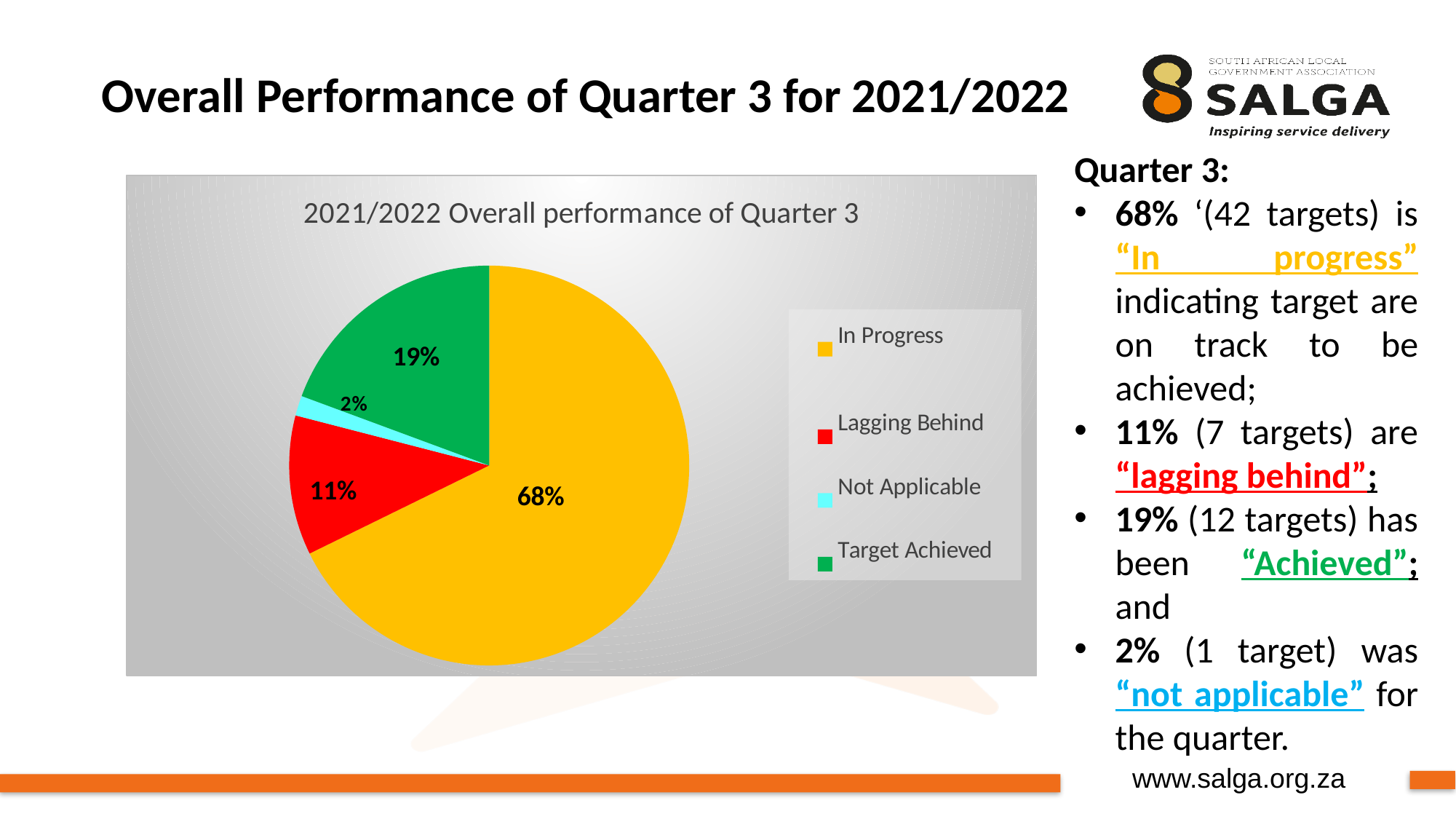
What kind of chart is shown on the slide? Pie chart What colour is the Lagging Behind slice? Red Which category has the largest slice of the pie? In Progress Which slice is larger, Target Achieved or Lagging Behind? Target Achieved What percentage of the pie is labelled Not Applicable? 2% Which category has the smallest slice of the pie? Not Applicable What percentage of the pie is labelled Lagging Behind? 11% How many categories does the legend list? 4 What is the difference in percentage points between the In Progress slice and the Target Achieved slice? 49 What percentage of the pie is labelled In Progress? 68% What percentage of the pie is labelled Target Achieved? 19% What is the title of the chart? 2021/2022 Overall performance of Quarter 3